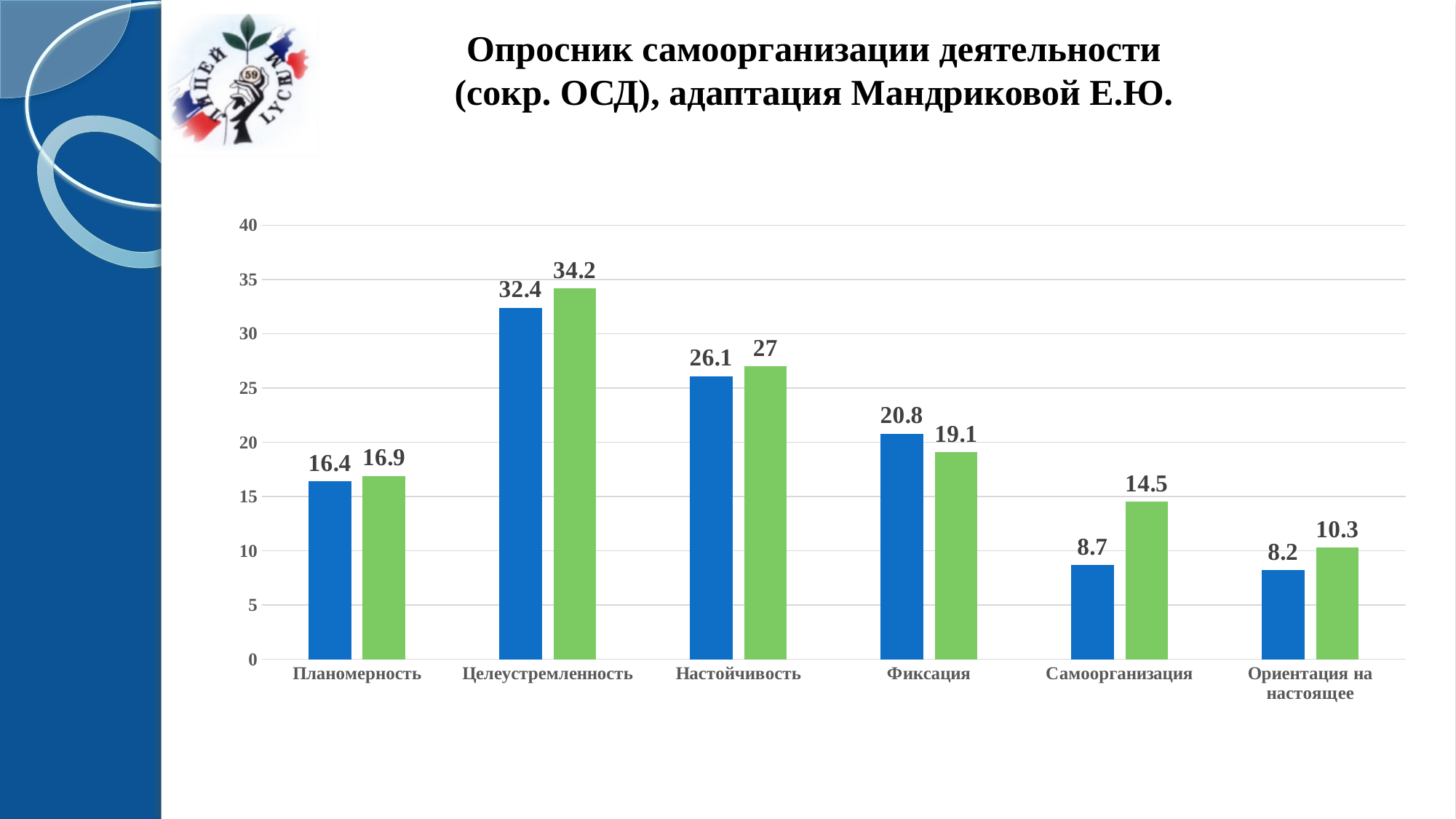
What is the value of the blue bar for Целеустремленность? 32.4 Is the green bar for Планомерность greater or less than 20? less How many categories are shown on the x axis? 6 What is the value of the blue bar for Ориентация на настоящее? 8.2 Which category has the lowest blue bar? Ориентация на настоящее How many bars are shown for each category? 2 What is the difference between the green and blue bars for Настойчивость? 0.9 For Фиксация, which bar is larger, the blue or the green? blue What is the difference between the blue bars for Целеустремленность and Самоорганизация? 23.7 What type of chart is shown on the slide? bar chart What is the value of the green bar for Самоорганизация? 14.5 Which category has the highest green bar? Целеустремленность